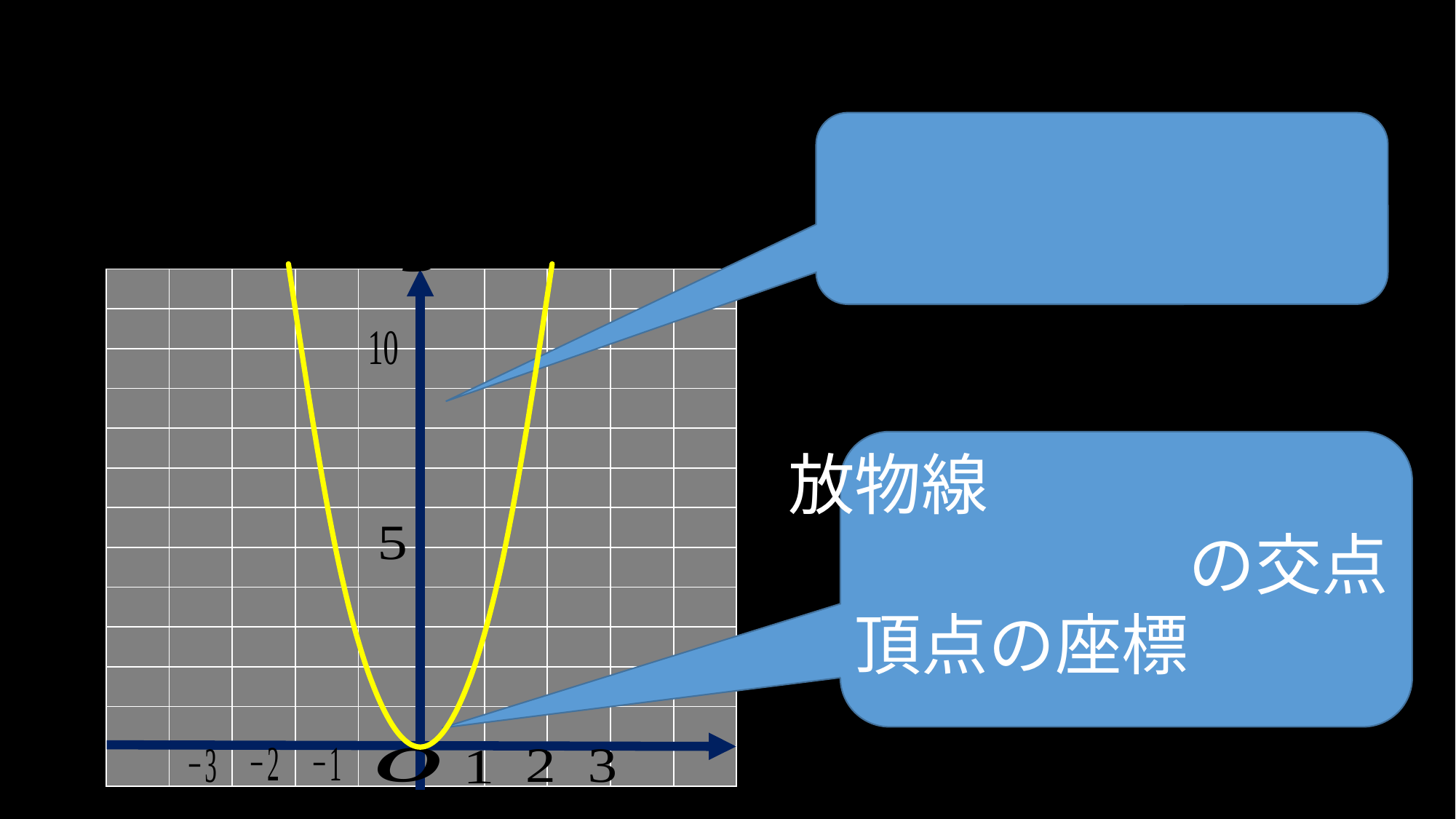
At which point does the yellow parabola reach its lowest value? the origin O (x = 0) What is the largest numbered tick label shown on the y axis? 10 Which is larger, the value of the curve at x = 1 or at x = 2? x = 2 Is the value of the yellow curve at x = 2 greater or less than 5? greater Does the parabola open upward or downward? upward What numbered tick labels are shown on the x axis? -3, -2, -1, 1, 2, 3 Does the yellow curve rise or fall as x increases from -3 to 0? fall Is the value of the yellow curve at x = -2 greater or less than 5? greater How many numbered tick labels (excluding O) are shown on the x axis? 6 Does the yellow curve rise or fall as x increases from 0 to 3? rise What kind of chart is shown on the slide? line chart (a parabola curve) Is the value of the yellow curve at x = 1 greater or less than 5? less